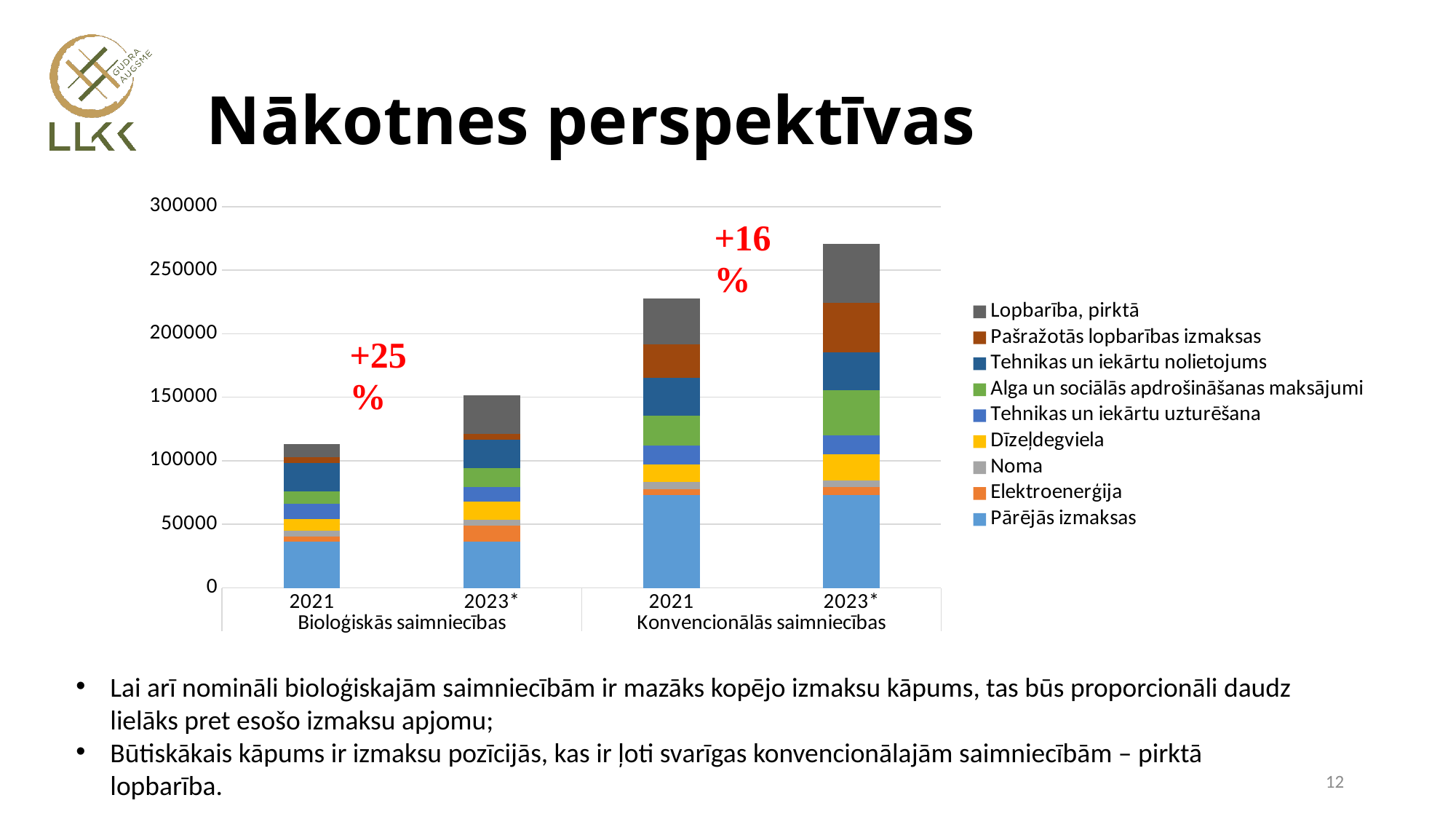
Which bar has the highest total? 2023* Konvencionālās saimniecības Which bar has the lowest total? 2021 Bioloģiskās saimniecības Do the totals for Bioloģiskās saimniecības rise or fall from 2021 to 2023*? rise Which is larger: the total for 2023* Bioloģiskās saimniecības or the total for 2021 Konvencionālās saimniecības? 2021 Konvencionālās saimniecības How many bars are plotted in the chart? 4 Is the total for 2021 Bioloģiskās saimniecības greater or less than 150000? less How many series does the legend list? 9 Is the total for 2023* Konvencionālās saimniecības greater or less than 250000? greater Is the total for 2021 Konvencionālās saimniecības greater or less than 200000? greater What percentage increase is annotated above the Bioloģiskās saimniecības bars? +25% What percentage increase is annotated above the Konvencionālās saimniecības bars? +16% What kind of chart is shown on the slide? stacked bar chart